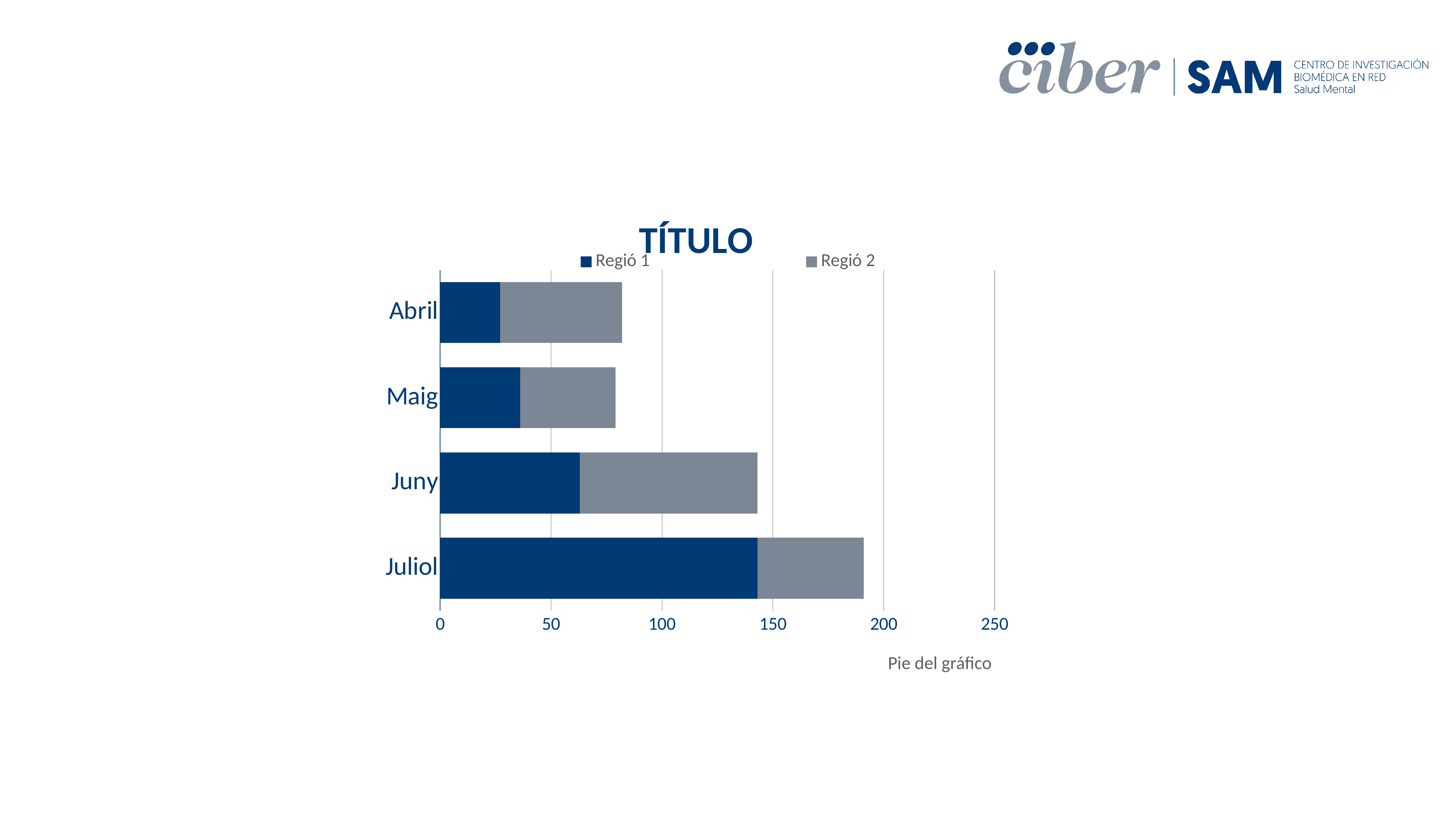
Is the Regió 1 value for Juliol greater or less than 100? greater Which month has the longest total bar? Juliol Do the Regió 1 values rise or fall going from Abril down to Juliol? rise Which month has the largest Regió 1 value? Juliol Which has the longer total bar, Juny or Maig? Juny Is the Regió 1 value for Maig greater or less than 50? less How many series does the legend list? 2 What are the two series named in the legend? Regió 1 and Regió 2 Is the total bar length for Abril greater or less than 100? less What kind of chart is shown on the slide? bar chart How many categories (months) are shown on the chart? 4 What is the title of the chart? TÍTULO